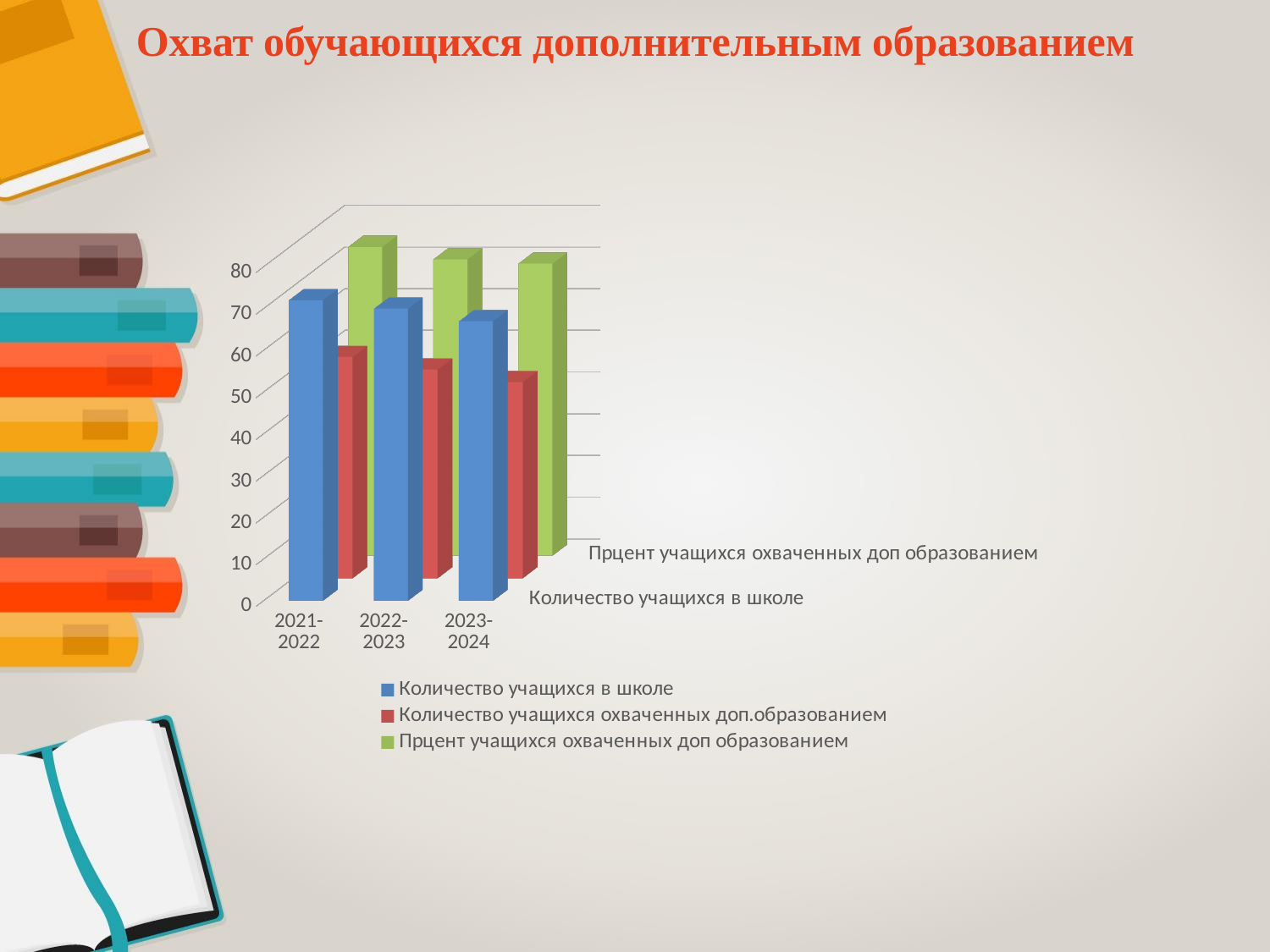
How many series does the legend list? 3 Do the values for 'Количество учащихся в школе' rise or fall from 2021-2022 to 2023-2024? fall Which colour represents the series 'Количество учащихся в школе'? blue What kind of chart is shown on the slide? bar chart Do the values for 'Количество учащихся охваченных доп.образованием' rise or fall from 2021-2022 to 2023-2024? fall Is the value for 'Количество учащихся охваченных доп.образованием' in 2023-2024 greater or less than 70? less In 2021-2022, which is larger: 'Количество учащихся в школе' or 'Количество учащихся охваченных доп.образованием'? Количество учащихся в школе Is the value for 'Количество учащихся в школе' in 2023-2024 greater or less than 80? less What is the title of the slide above the chart? Охват обучающихся дополнительным образованием Is the value for 'Прцент учащихся охваченных доп образованием' in 2021-2022 greater or less than 40? greater How many school years are shown on the x axis? 3